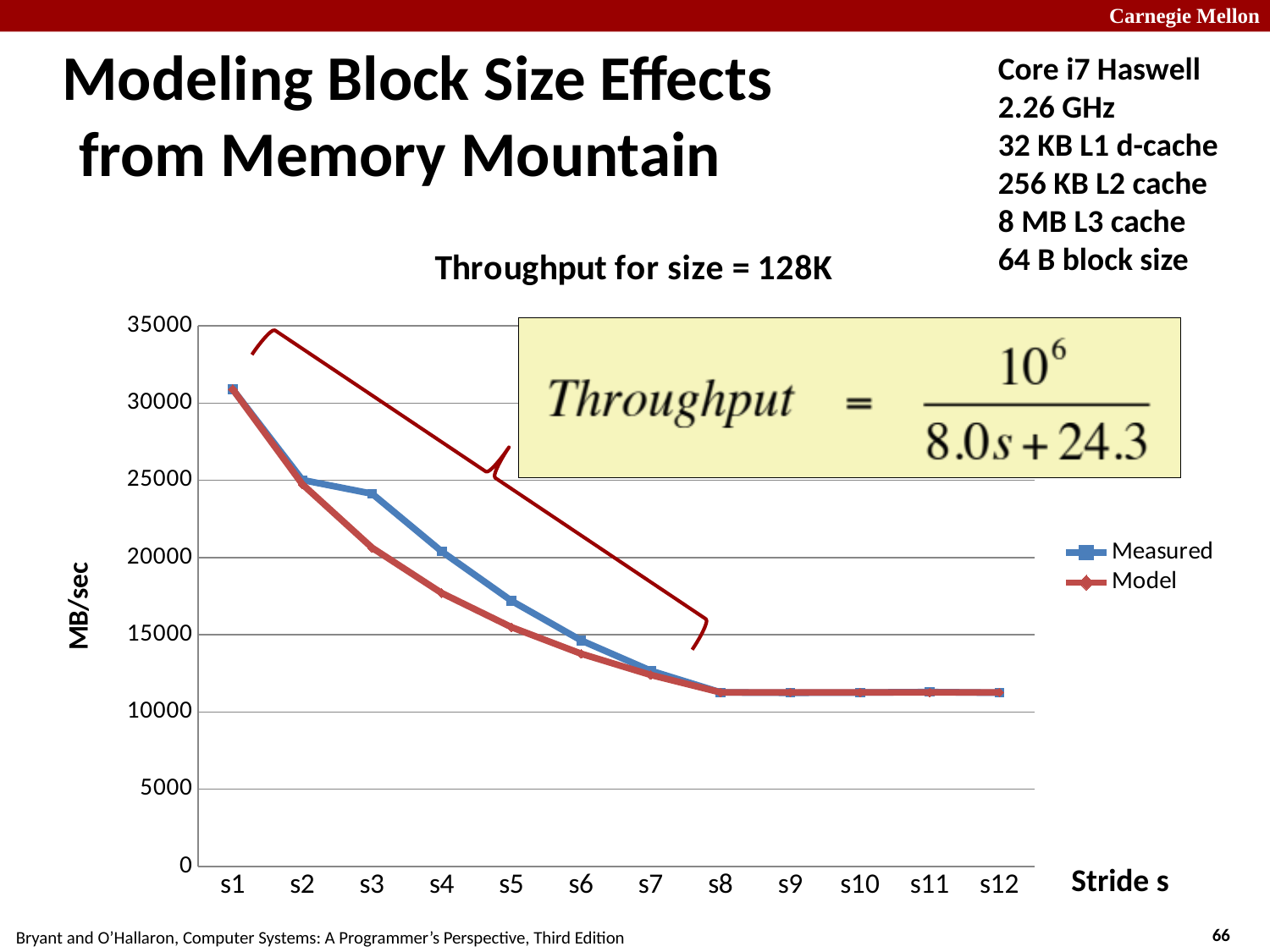
How many stride values are plotted along the x axis? 12 Is the Measured value at s1 greater or less than 30000? greater What kind of chart is shown on the slide? line chart Do the Measured values rise or fall as the stride increases from s1 to s8? fall What is the label of the y axis? MB/sec Is the Model value at s6 greater or less than 15000? less Is the Measured value at s8 greater or less than 10000? greater At stride s3, which series has the larger value, Measured or Model? Measured How many series does the chart legend list? 2 What is the title of the chart? Throughput for size = 128K At which stride is the Measured throughput highest? s1